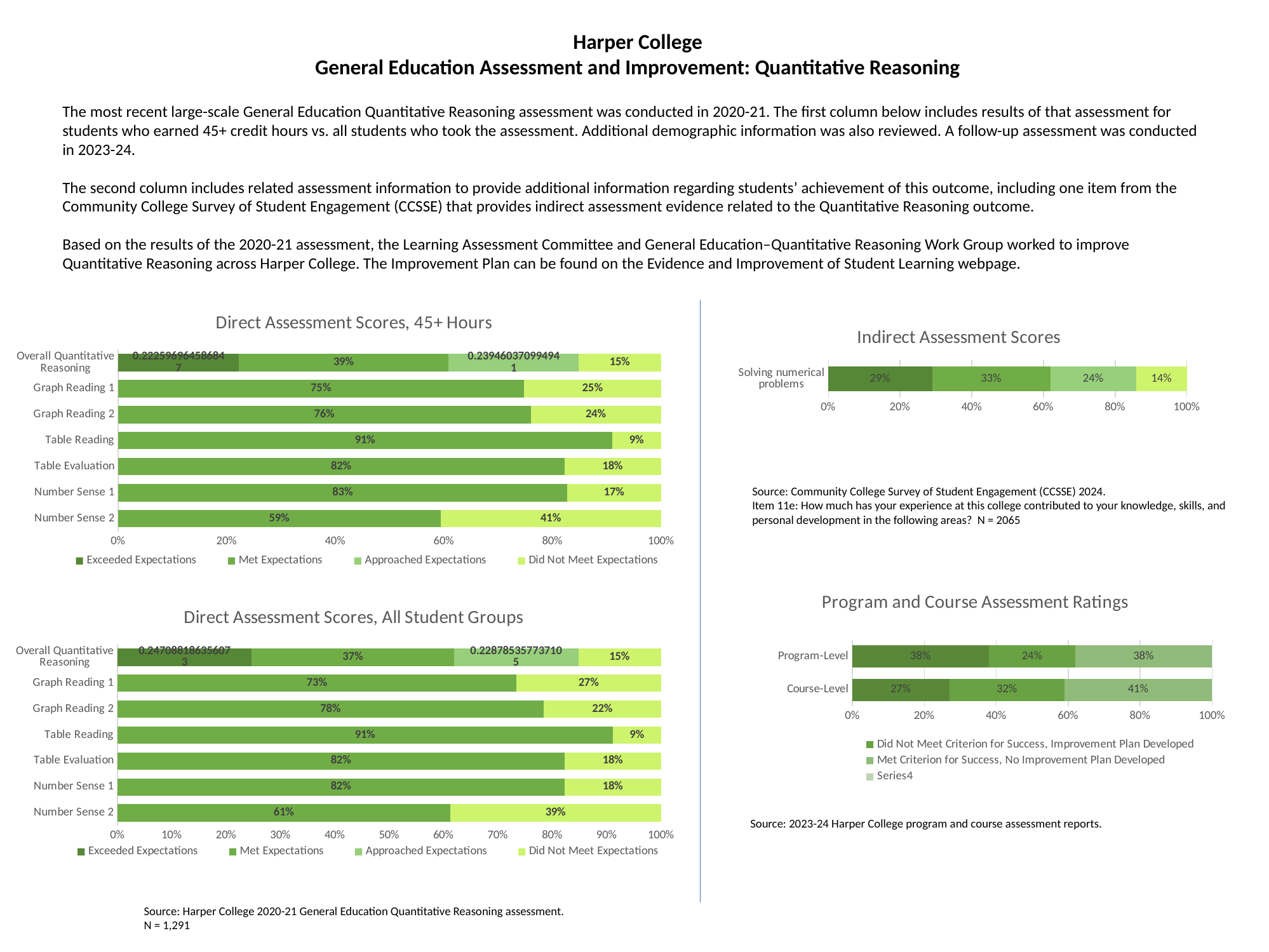
How many series does the legend of the 'Direct Assessment Scores, All Student Groups' chart list? 4 In the 'Direct Assessment Scores, All Student Groups' chart, what is the Met Expectations value for Graph Reading 2? 78% In the 'Indirect Assessment Scores' chart, what is the value of the first (darkest) segment for Solving numerical problems? 29% In the 'Direct Assessment Scores, 45+ Hours' chart, which category has the highest Did Not Meet Expectations value? Number Sense 2 In the 'Direct Assessment Scores, 45+ Hours' chart, what is the Met Expectations value for Table Reading? 91% In the 'Indirect Assessment Scores' chart, what is the value of the last (lightest) segment for Solving numerical problems? 14% In the 'Direct Assessment Scores, All Student Groups' chart, what is the difference between the Did Not Meet Expectations values for Number Sense 2 and Table Reading? 30% In the 'Direct Assessment Scores, 45+ Hours' chart, what is the Did Not Meet Expectations value for Number Sense 2? 41% In the 'Direct Assessment Scores, 45+ Hours' chart, how many categories are shown on the vertical axis? 7 What type of chart is 'Program and Course Assessment Ratings'? Stacked bar chart In the 'Direct Assessment Scores, All Student Groups' chart, which is larger: the Met Expectations value for Graph Reading 1 or for Graph Reading 2? Graph Reading 2